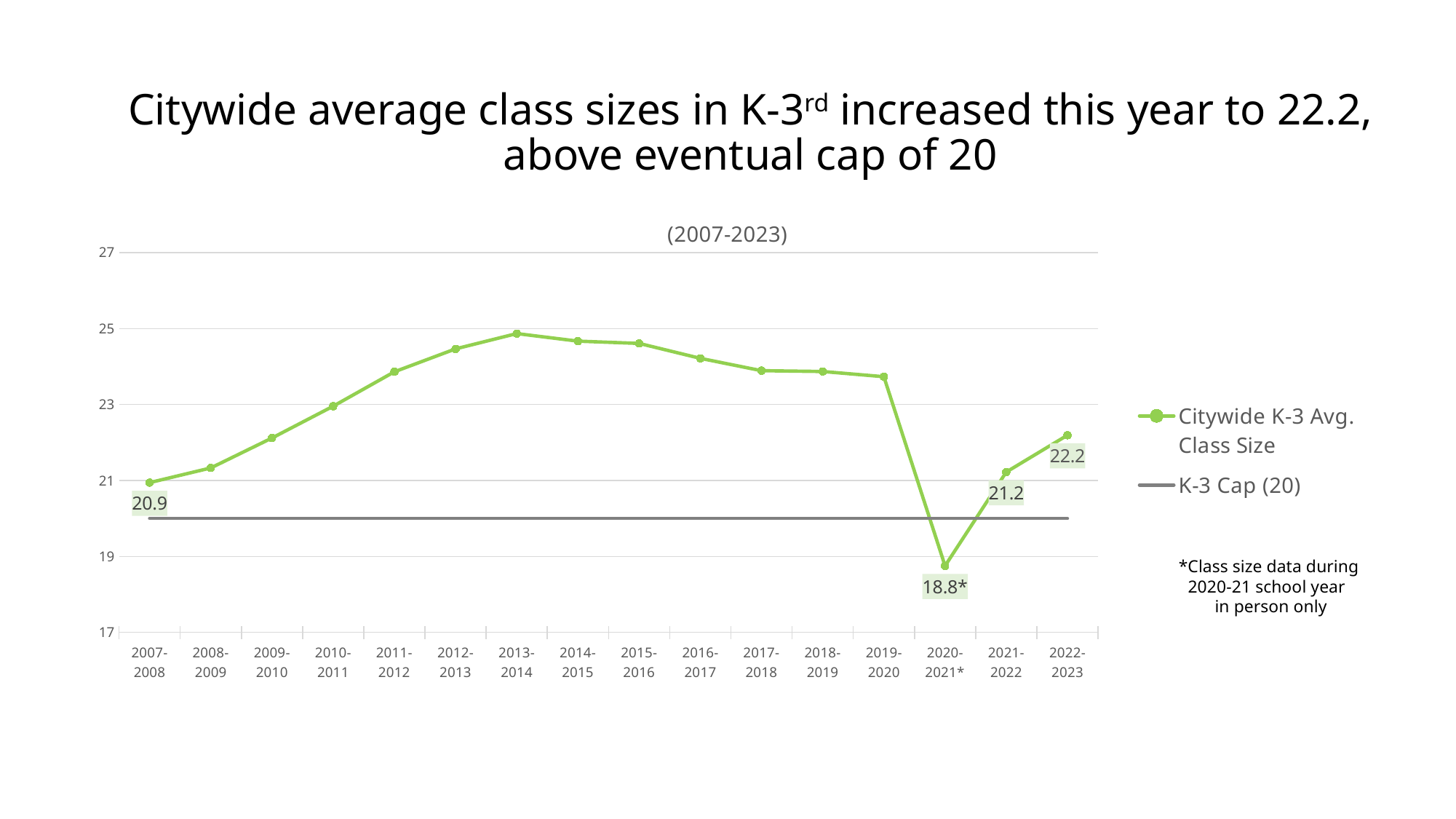
What is the difference between the Citywide K-3 Avg. Class Size in 2022-2023 and 2021-2022? 1.0 What is the Citywide K-3 Avg. Class Size for 2007-2008? 20.9 How many series does the legend list? 2 What is the Citywide K-3 Avg. Class Size for 2020-2021? 18.8* Which is larger, the Citywide K-3 Avg. Class Size in 2013-2014 or in 2007-2008? 2013-2014 Which school year has the lowest Citywide K-3 Avg. Class Size? 2020-2021* What is the Citywide K-3 Avg. Class Size for 2021-2022? 21.2 How many school years are plotted on the x axis? 16 What is the Citywide K-3 Avg. Class Size for 2022-2023? 22.2 Is the Citywide K-3 Avg. Class Size for 2013-2014 greater or less than 23? greater Which school year has the highest Citywide K-3 Avg. Class Size? 2013-2014 What kind of chart is shown on the slide? line chart